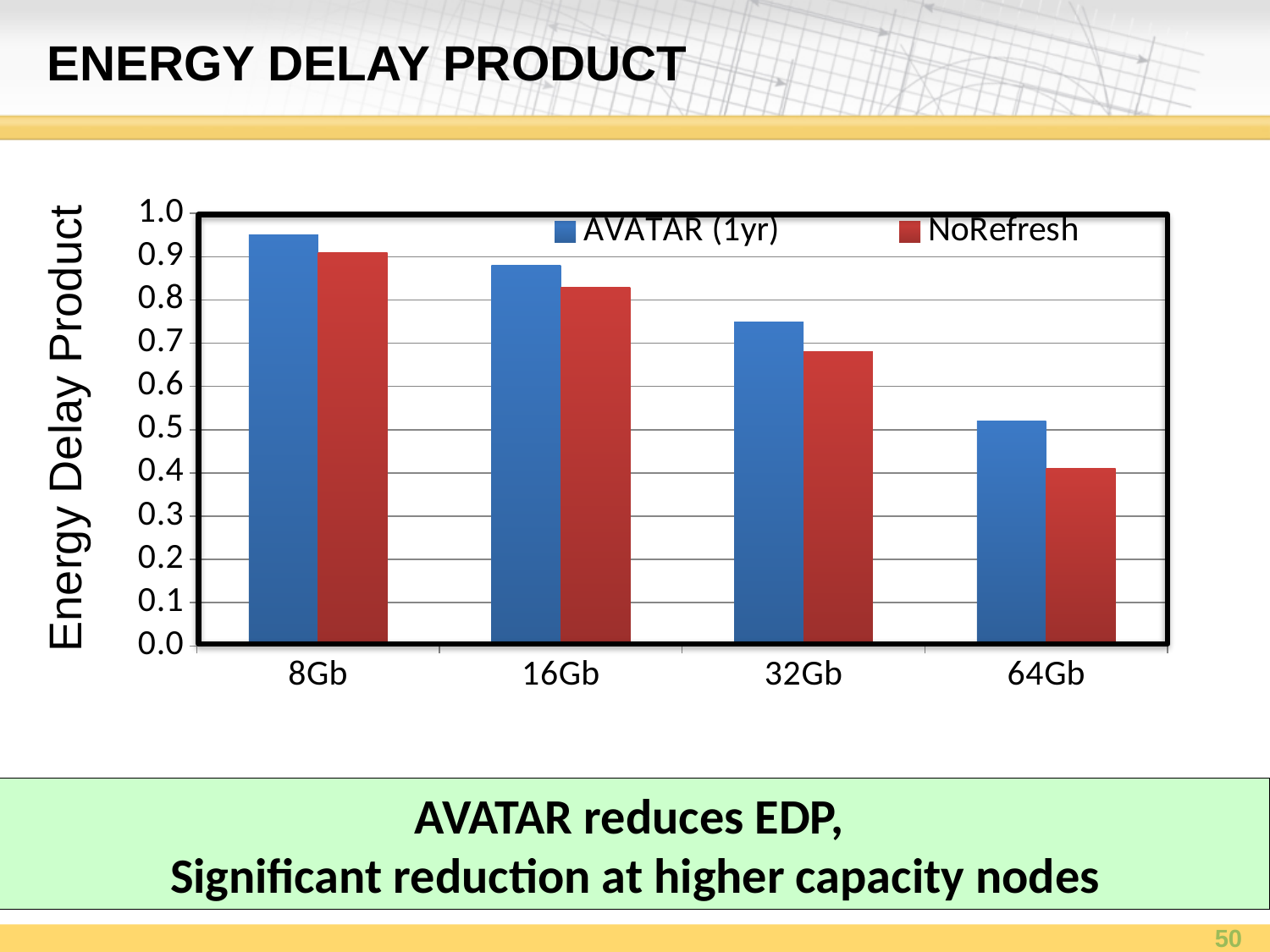
Is the NoRefresh value for 64Gb greater or less than 0.5? less Do the NoRefresh values rise or fall as capacity increases from 8Gb to 64Gb? fall What kind of chart is shown on the slide? Bar chart Is the AVATAR (1yr) value for 8Gb greater or less than 0.9? greater Is the AVATAR (1yr) value for 16Gb greater or less than 0.9? less For which capacity is the NoRefresh bar lowest? 64Gb At 64Gb, which series has the larger value, AVATAR (1yr) or NoRefresh? AVATAR (1yr) For which capacity is the AVATAR (1yr) bar highest? 8Gb How many capacity categories are shown on the x axis? 4 How many series does the legend list? 2